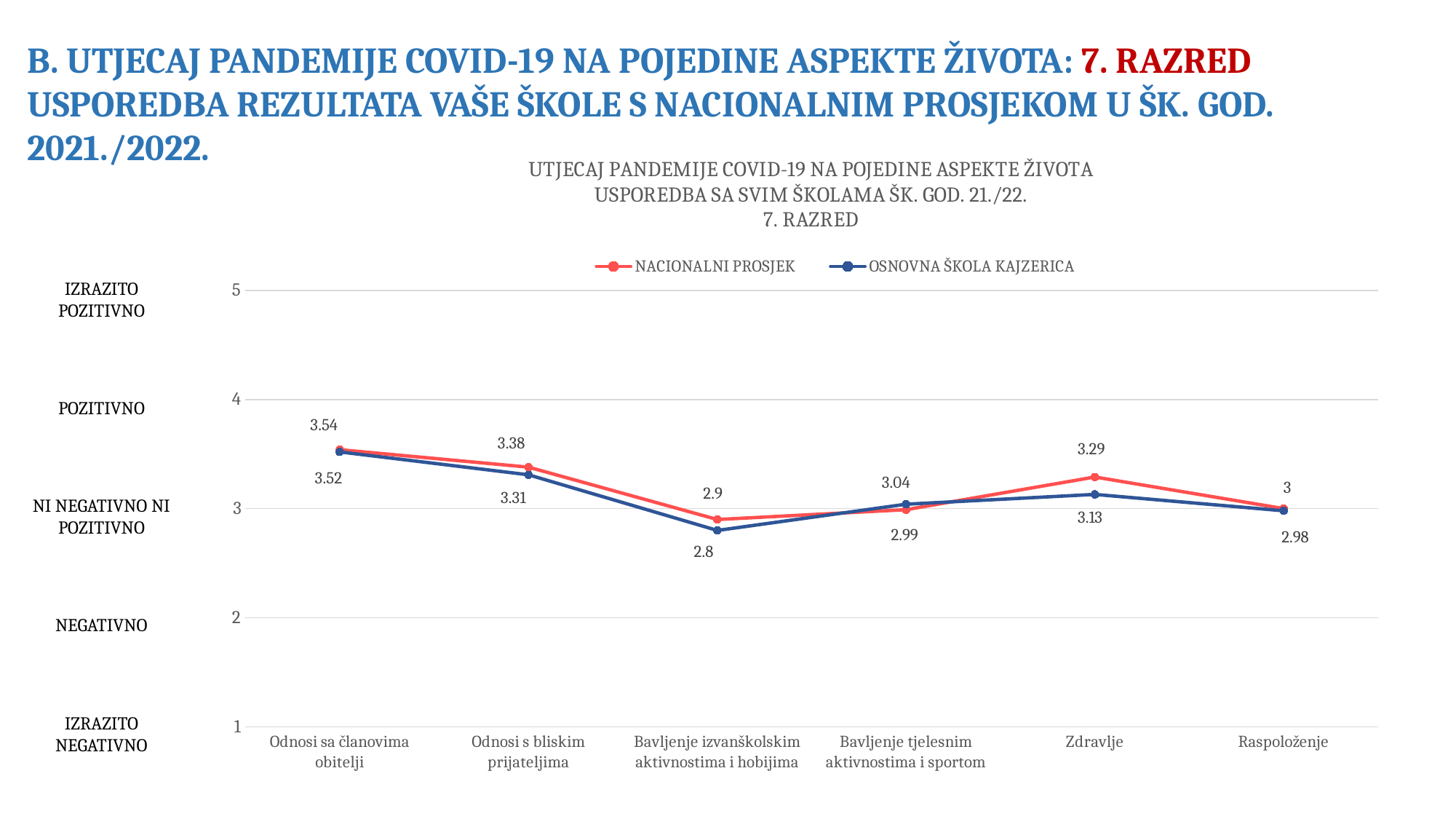
Which category has the highest NACIONALNI PROSJEK value? Odnosi sa članovima obitelji Is the OSNOVNA ŠKOLA KAJZERICA value for Bavljenje izvanškolskim aktivnostima i hobijima greater or less than 3? less What is the OSNOVNA ŠKOLA KAJZERICA value for Bavljenje tjelesnim aktivnostima i sportom? 3.04 What type of chart is shown on the slide? line chart Which colour is used for the NACIONALNI PROSJEK series in the chart? red What is the NACIONALNI PROSJEK value for Zdravlje? 3.29 What is the difference between the NACIONALNI PROSJEK and OSNOVNA ŠKOLA KAJZERICA values for Zdravlje? 0.16 For Bavljenje tjelesnim aktivnostima i sportom, which series has the larger value: NACIONALNI PROSJEK or OSNOVNA ŠKOLA KAJZERICA? OSNOVNA ŠKOLA KAJZERICA How many series does the chart legend list? 2 How many categories are shown on the x axis of the chart? 6 What is the OSNOVNA ŠKOLA KAJZERICA value for Raspoloženje? 2.98 Which category has the lowest OSNOVNA ŠKOLA KAJZERICA value? Bavljenje izvanškolskim aktivnostima i hobijima